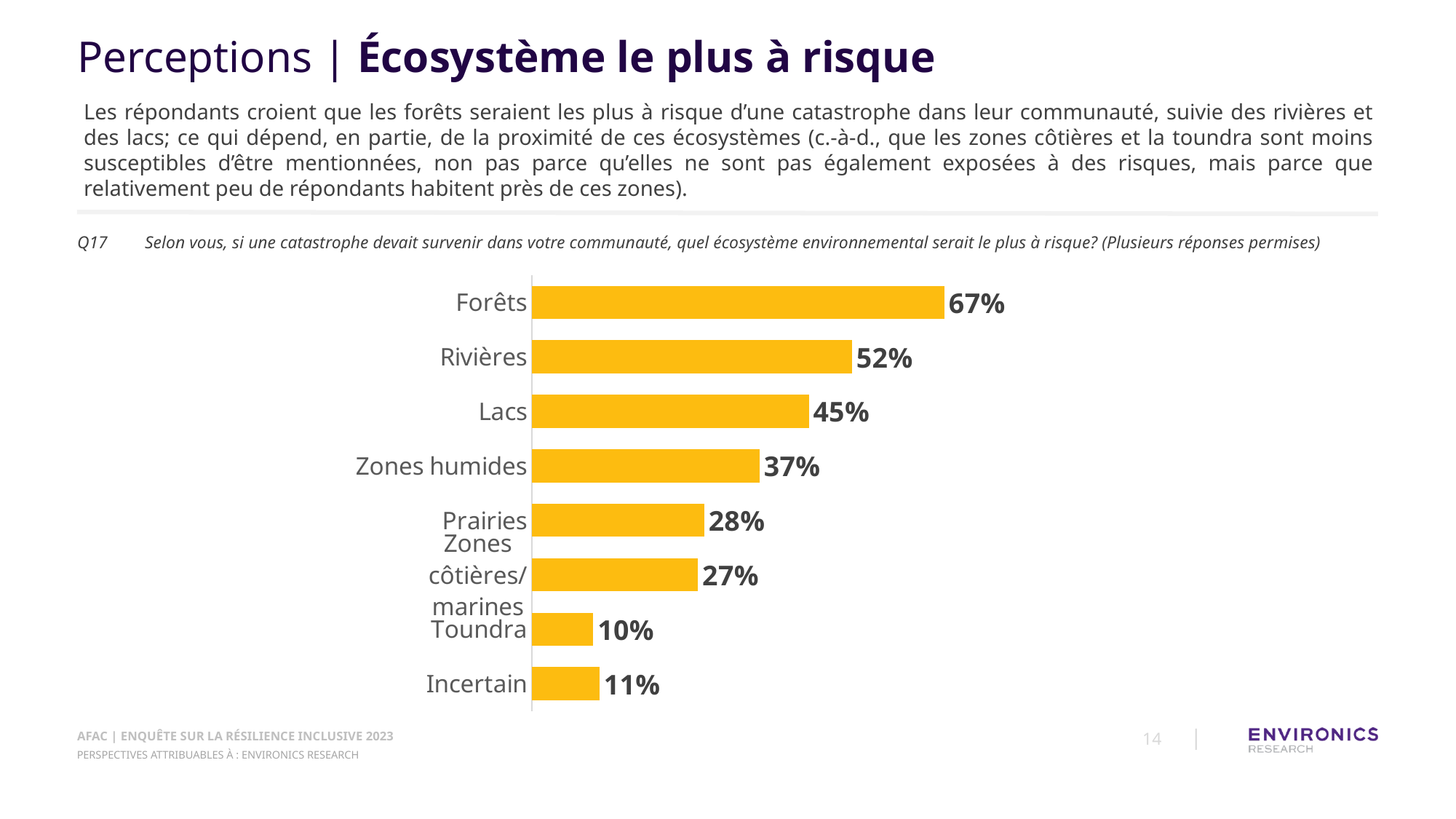
What is the value shown for Zones côtières/marines? 27% Which has a larger value, Prairies or Toundra? Prairies What colour are the bars in the chart? Yellow What is the difference between the values for Forêts and Rivières? 15% What is the value shown for Rivières? 52% What is the difference between the values for Lacs and Zones humides? 8% Which category has the highest value in the chart? Forêts What is the value shown for Zones humides? 37% How many categories are shown in the chart? 8 What percentage of respondents named Forêts as the ecosystem most at risk? 67% What kind of chart is shown on the slide? Bar chart Which category has the lowest value in the chart? Toundra